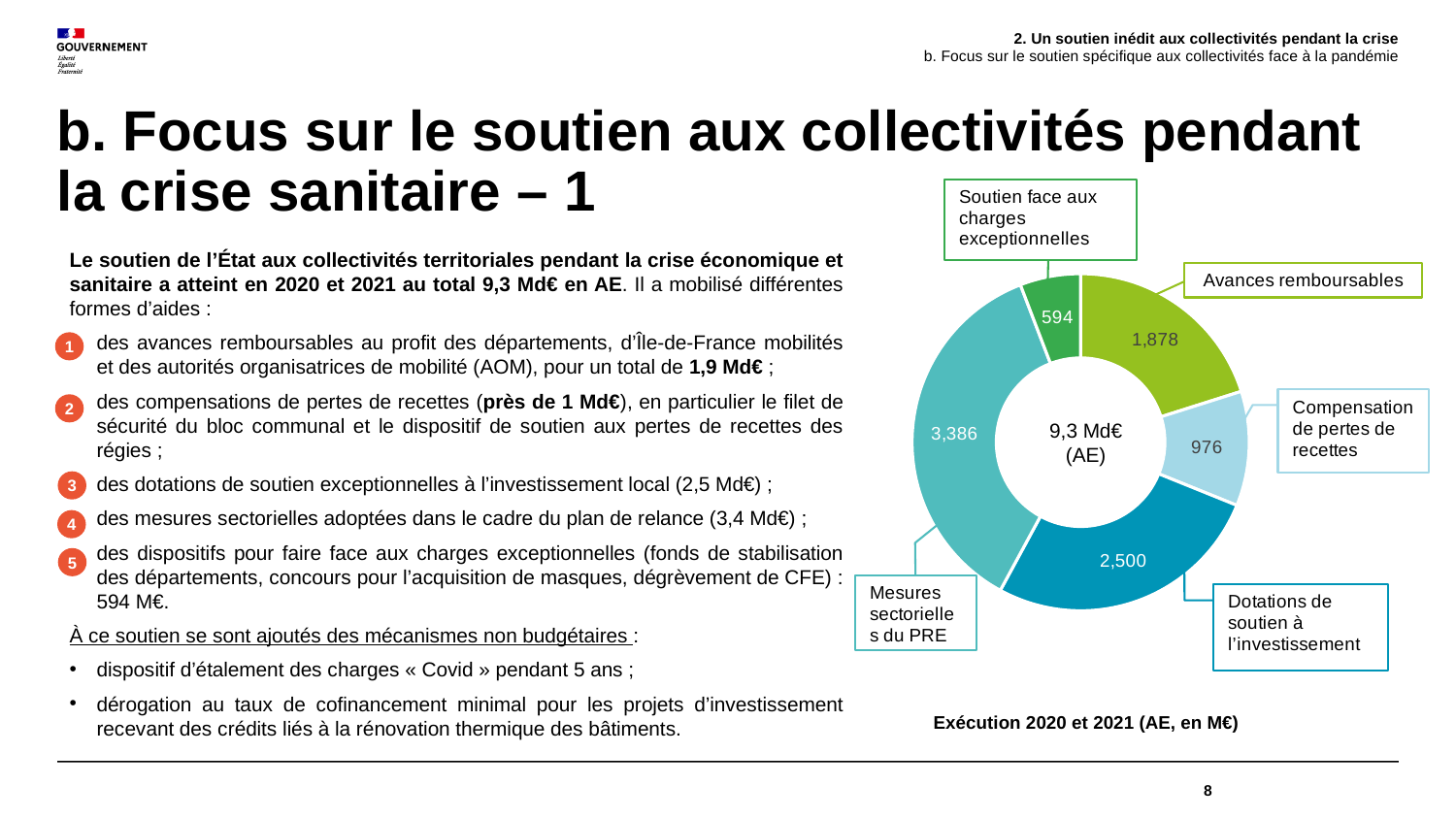
What is the value for Mesures sectorielles du PRE? 3,386 What kind of chart is shown on the slide? Donut (pie) chart Which category has the smallest value in the chart? Soutien face aux charges exceptionnelles Which category has the largest value in the chart? Mesures sectorielles du PRE What total amount is shown in the centre of the donut chart? 9,3 Md€ (AE) Which is larger: Avances remboursables or Compensation de pertes de recettes? Avances remboursables How many categories (slices) does the chart have? 5 What is the value for Soutien face aux charges exceptionnelles? 594 What is the difference between Mesures sectorielles du PRE and Dotations de soutien à l'investissement? 886 What is the value for Dotations de soutien à l'investissement? 2,500 What is the value for Avances remboursables? 1,878 What is the value for Compensation de pertes de recettes? 976